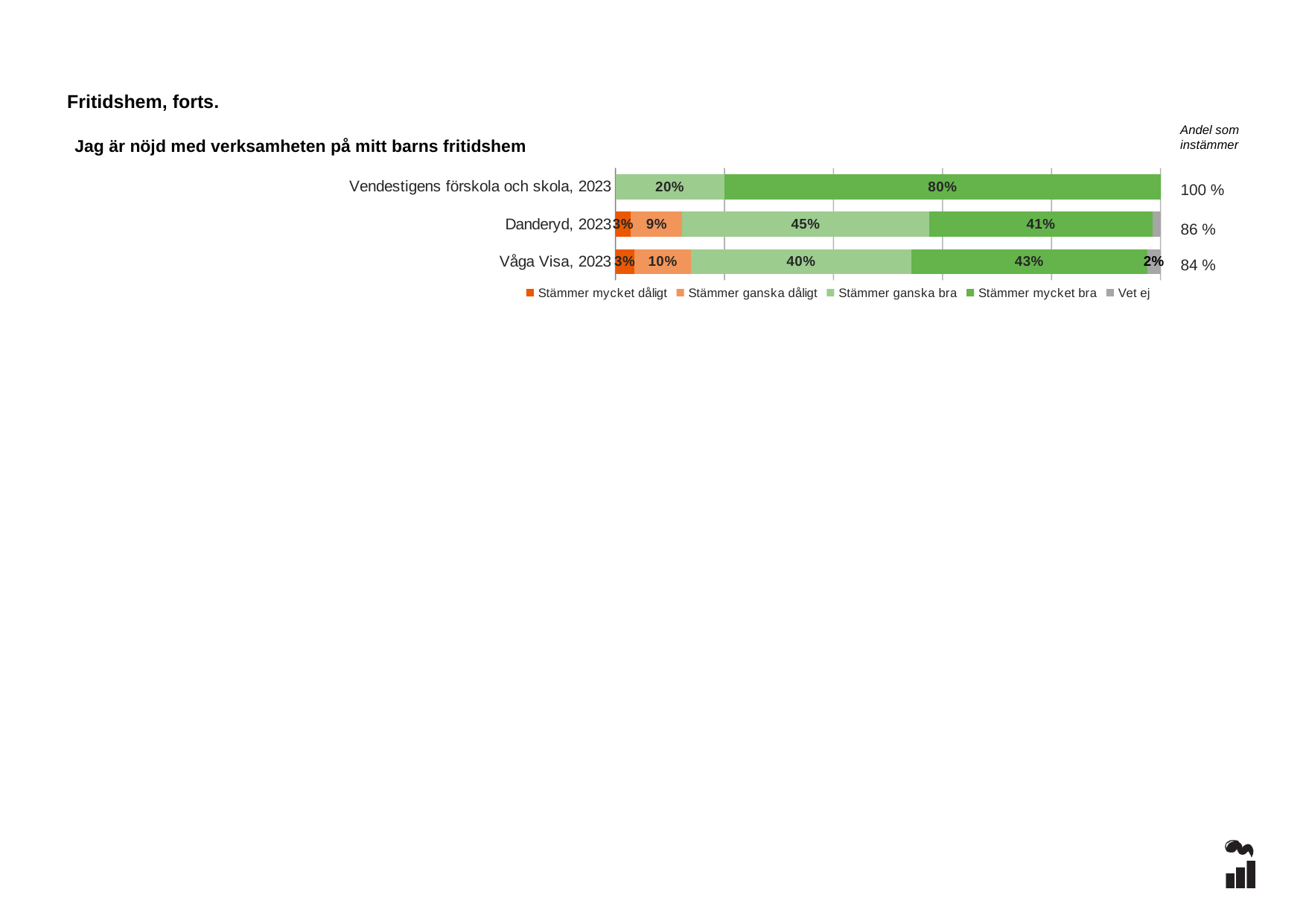
What is the "Andel som instämmer" value shown for Danderyd, 2023? 86 % What percentage of respondents for Danderyd, 2023 answered "Stämmer ganska bra"? 45% How many series does the legend list? 5 What percentage of respondents for Vendestigens förskola och skola, 2023 answered "Stämmer mycket bra"? 80% Which category has the highest "Stämmer mycket bra" share? Vendestigens förskola och skola, 2023 What is the difference between the "Stämmer mycket bra" share for Vendestigens förskola och skola, 2023 and for Danderyd, 2023? 39 percentage points Which is larger: the "Stämmer ganska bra" share for Danderyd, 2023 or for Våga Visa, 2023? Danderyd, 2023 What kind of chart is shown on the slide? Stacked bar chart How many categories (bars) are shown in the chart? 3 What is the title of the chart? Jag är nöjd med verksamheten på mitt barns fritidshem Which category has the lowest "Andel som instämmer" value? Våga Visa, 2023 What percentage of respondents for Våga Visa, 2023 answered "Stämmer ganska dåligt"? 10%